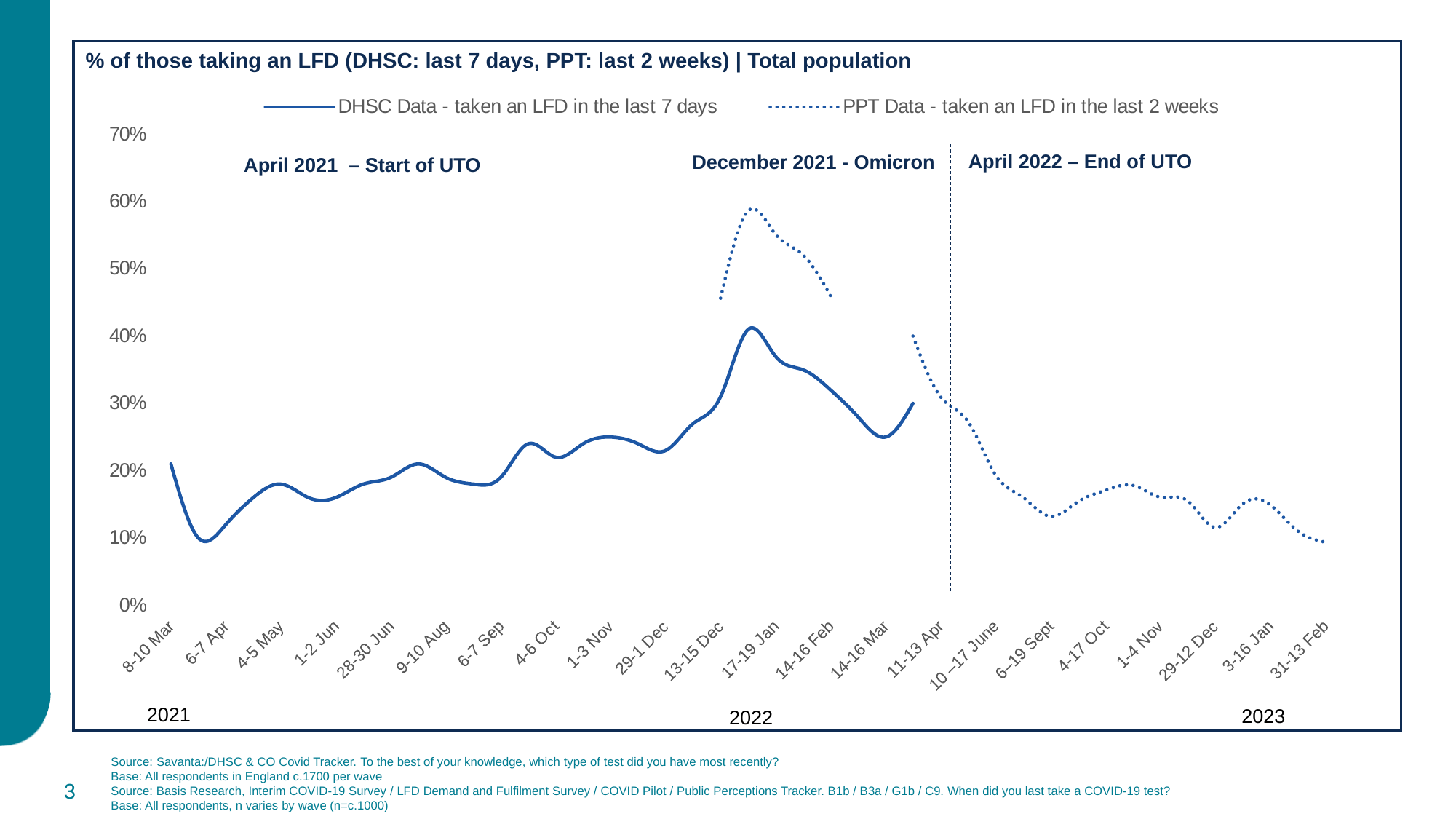
Is the value of the PPT Data series at 17-19 Jan greater or less than 50%? greater What is the title of the chart? % of those taking an LFD (DHSC: last 7 days, PPT: last 2 weeks) | Total population Does the PPT Data series rise or fall between 11-13 Apr and 10–17 June? fall Is the value of the DHSC Data series at 6-7 Apr greater or less than 20%? less Is the value of the PPT Data series at 31-13 Feb greater or less than 20%? less Which series is drawn with a dotted line? PPT Data - taken an LFD in the last 2 weeks At 17-19 Jan, which series has the higher value, DHSC Data or PPT Data? PPT Data What kind of chart is shown on the slide? line chart How many series does the legend list? 2